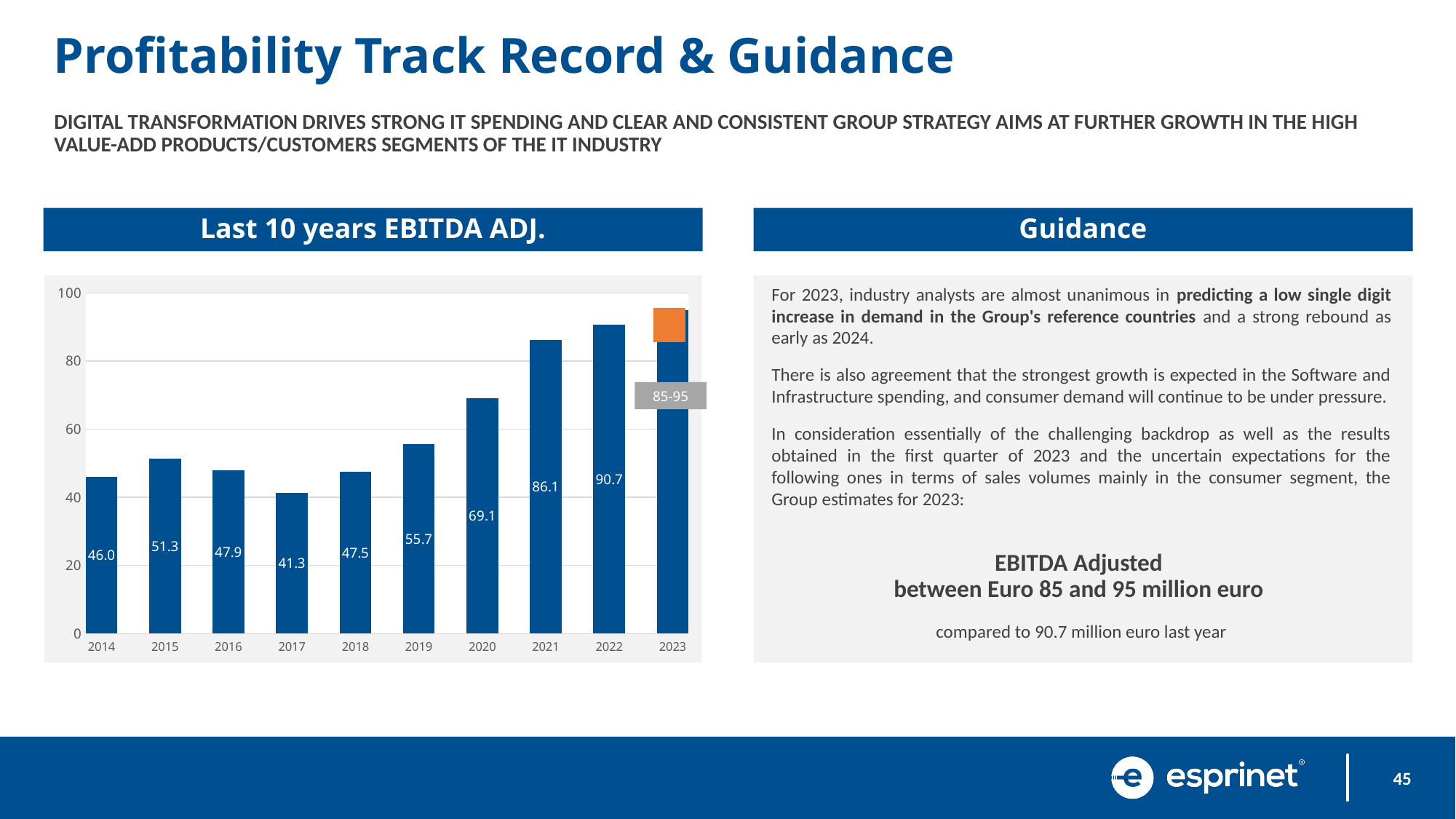
What is the EBITDA ADJ. value for 2022? 90.7 What is the difference between the EBITDA ADJ. values for 2022 and 2021? 4.6 Which year has the highest labelled EBITDA ADJ. value among 2014 to 2022? 2022 Is the value for 2019 greater or less than 60? less What kind of chart is used to show the last 10 years EBITDA ADJ.? bar chart What is the EBITDA ADJ. value for 2017? 41.3 Which is larger, the EBITDA ADJ. value for 2015 or for 2016? 2015 Do the EBITDA ADJ. values generally rise or fall from 2017 to 2022? rise What label is shown for the 2023 bar? 85-95 How many years are shown on the x axis of the chart? 10 What is the EBITDA ADJ. value for 2020? 69.1 Which year has the lowest EBITDA ADJ. value? 2017